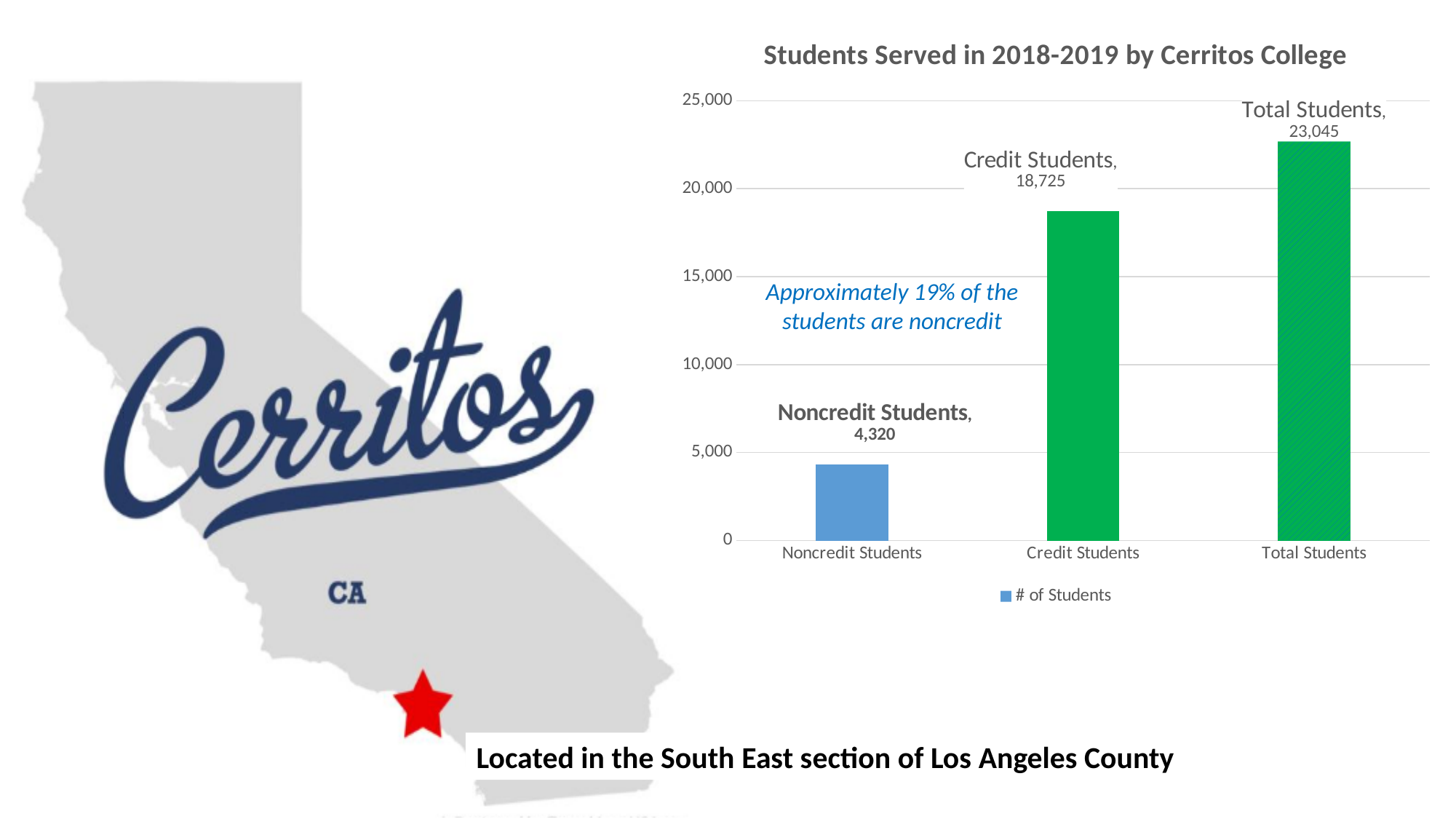
What kind of chart is shown on the slide? bar chart Which category has the lowest value? Noncredit Students How many categories are shown on the x axis? 3 Which is larger, Credit Students or Noncredit Students? Credit Students What is the value for Credit Students? 18,725 What is the difference between Total Students and Credit Students? 4,320 What is the value for Total Students? 23,045 What is the title of the chart? Students Served in 2018-2019 by Cerritos College What is the value for Noncredit Students? 4,320 What is the difference between Credit Students and Noncredit Students? 14,405 Which category has the highest value? Total Students Is the value for Credit Students greater or less than 15,000? greater